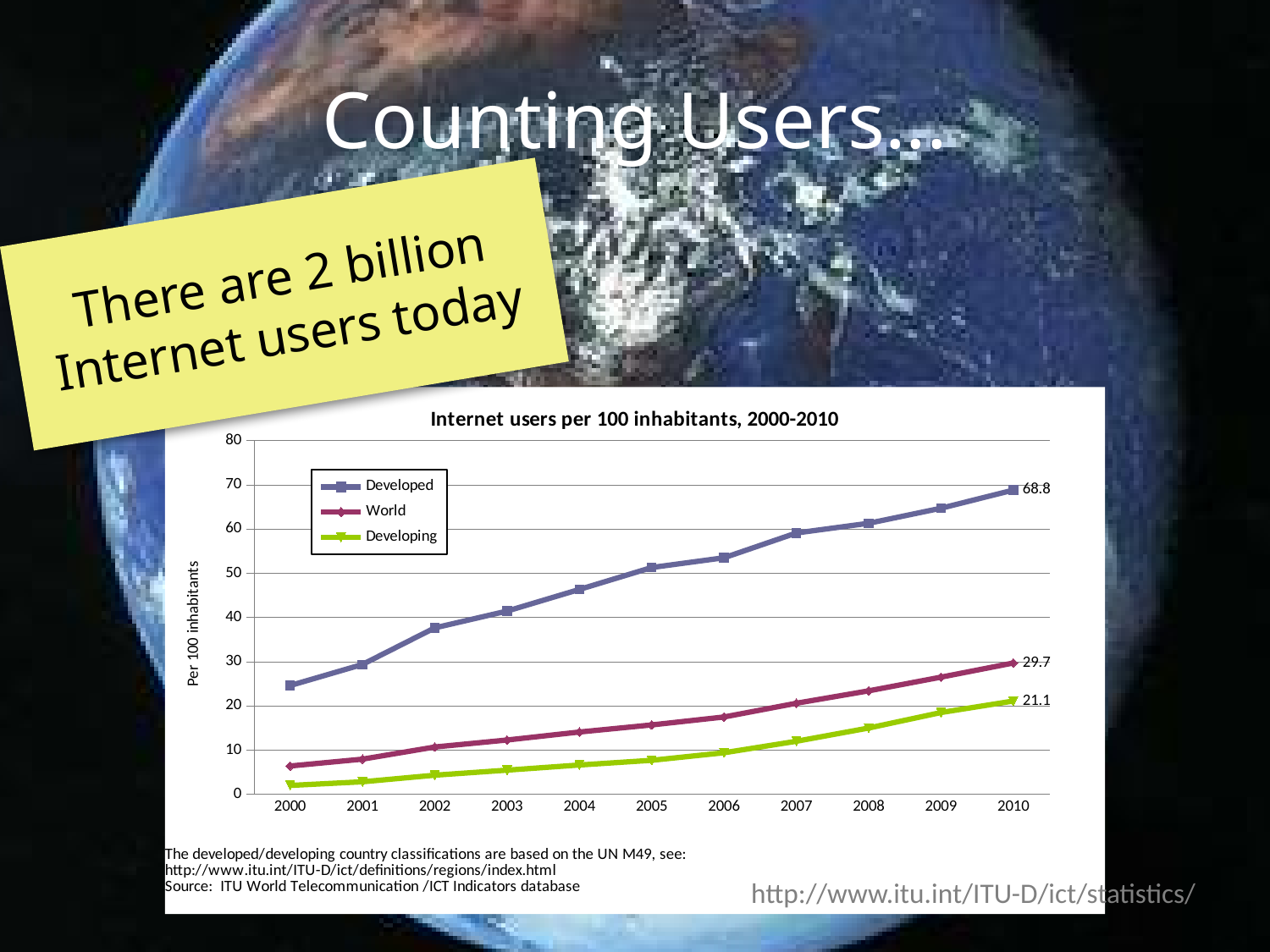
Is the value for Developing in 2009 greater or less than 20? less What is the value for Developed in 2010? 68.8 Which series has the highest value in 2010? Developed What kind of chart is shown on the slide? Line chart Which series has the lowest value in 2010? Developing How many years are plotted on the x axis? 11 What is the difference between the World and Developing values in 2010? 8.6 What is the value for World in 2010? 29.7 What is the value for Developing in 2010? 21.1 How many series does the legend list? 3 Is the value for Developed in 2000 greater or less than 30? less What is the difference between the Developed and World values in 2010? 39.1